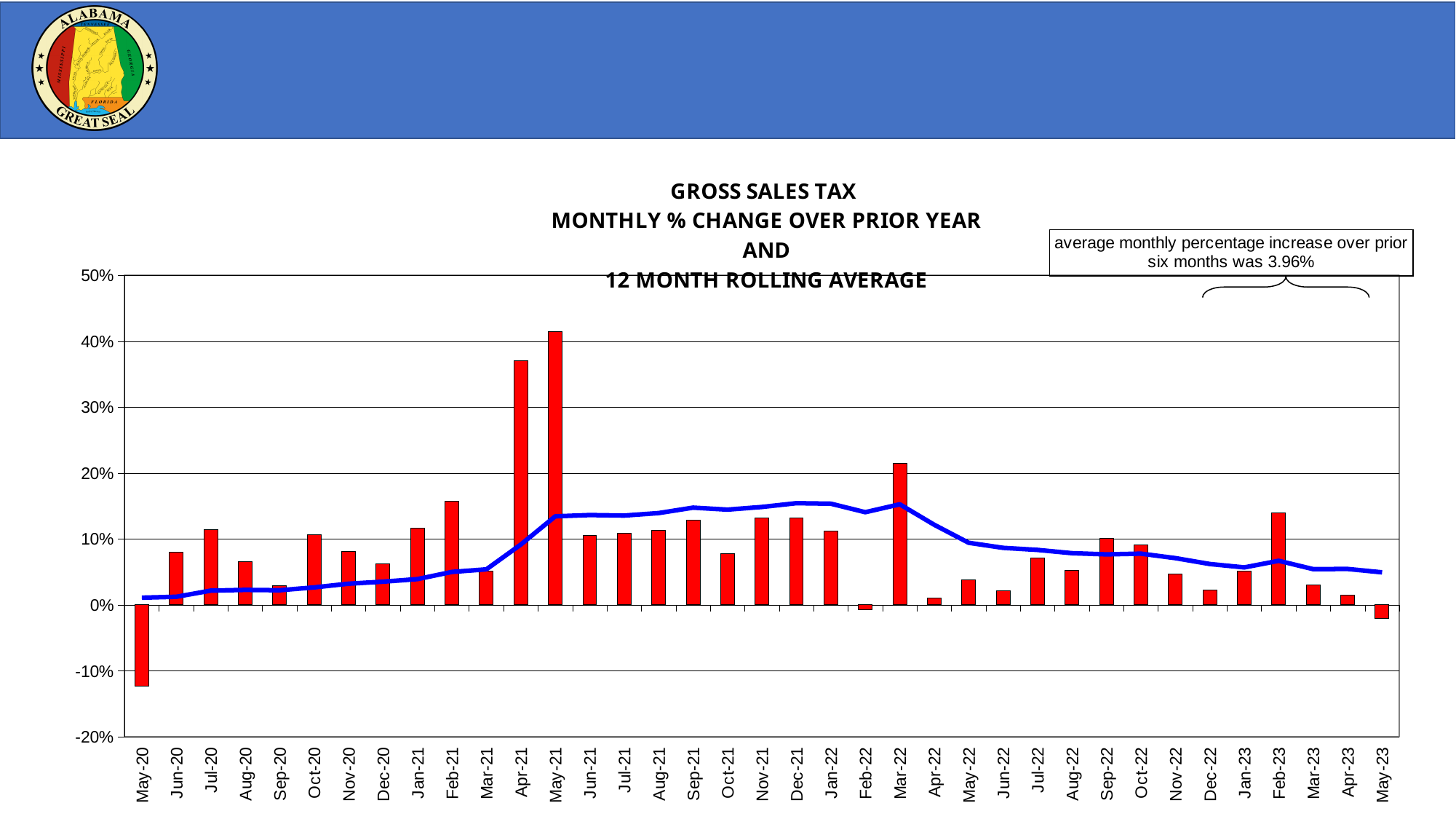
Which month has the lowest bar in the chart? May-20 Which bar is taller, Apr-21 or Mar-22? Apr-21 Which month has the highest bar in the chart? May-21 According to the text box on the slide, what was the average monthly percentage increase over the prior six months? 3.96% Does the blue 12-month rolling average line rise or fall from Mar-22 to May-23? fall Is the bar for Apr-21 greater or less than 30%? greater Is the bar for Feb-23 greater or less than 10%? greater Is the bar for Mar-22 greater or less than 20%? greater Which bar is taller, Feb-23 or Mar-23? Feb-23 How many months are shown on the x axis? 37